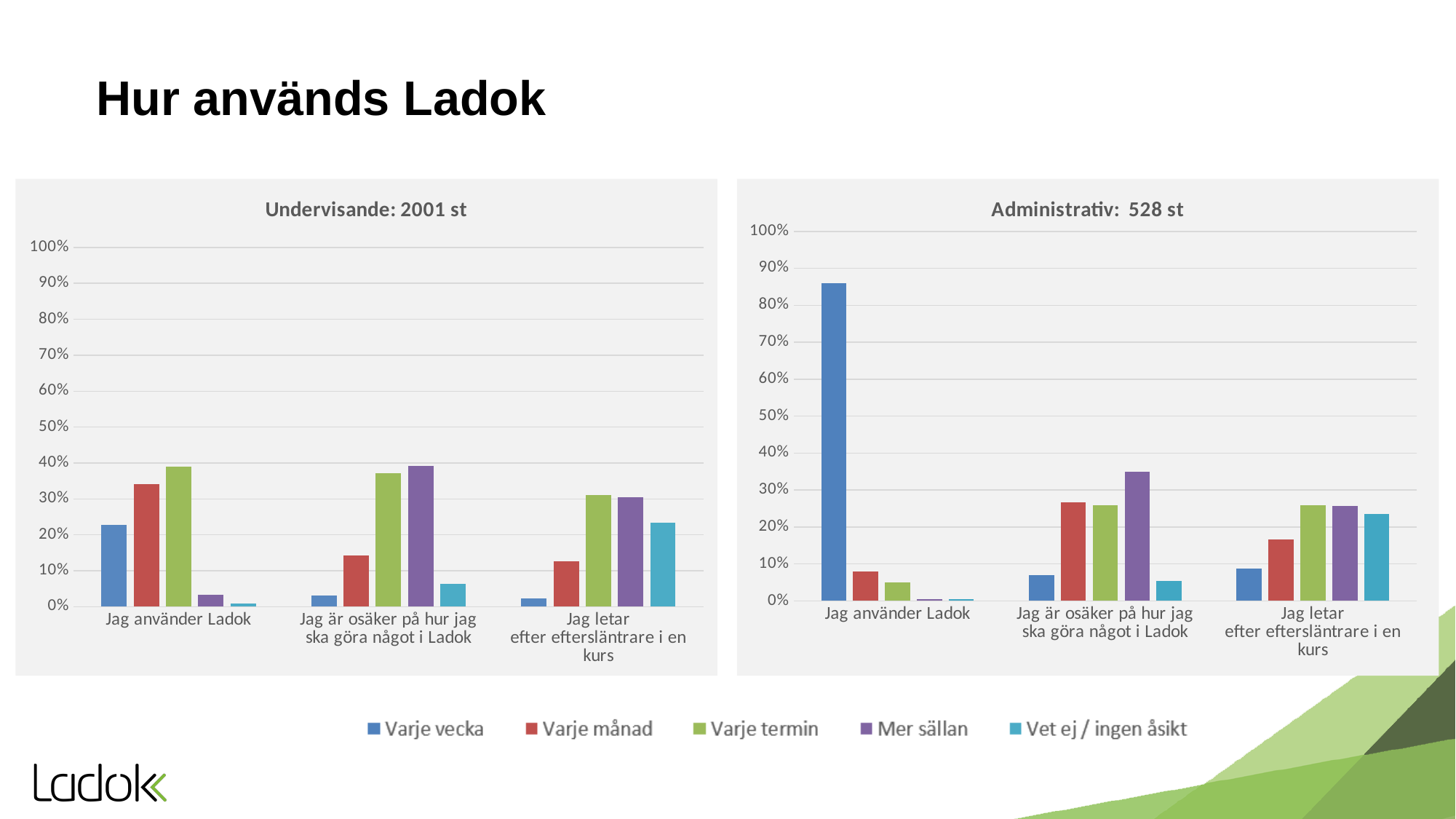
In the "Administrativ: 528 st" chart, which series has the highest value for "Jag är osäker på hur jag ska göra något i Ladok"? Mer sällan In the "Undervisande: 2001 st" chart, is the value of "Varje termin" for "Jag använder Ladok" greater or less than 30%? greater In the "Administrativ: 528 st" chart, which series has the highest value for "Jag använder Ladok"? Varje vecka In the "Administrativ: 528 st" chart, is the value of "Varje vecka" for "Jag letar efter eftersläntrare i en kurs" greater or less than 20%? less In the "Undervisande: 2001 st" chart, is the value of "Vet ej / ingen åsikt" for "Jag letar efter eftersläntrare i en kurs" greater or less than 20%? greater What colour represents the "Mer sällan" series in the legend? purple In the "Undervisande: 2001 st" chart, which series has the lowest value for "Jag använder Ladok"? Vet ej / ingen åsikt How many series does the legend list? 5 In the "Undervisande: 2001 st" chart, which is larger for "Jag är osäker på hur jag ska göra något i Ladok": "Varje vecka" or "Varje månad"? Varje månad How many categories are shown on the x axis of the "Administrativ: 528 st" chart? 3 What kind of chart is the "Undervisande: 2001 st" chart? bar chart